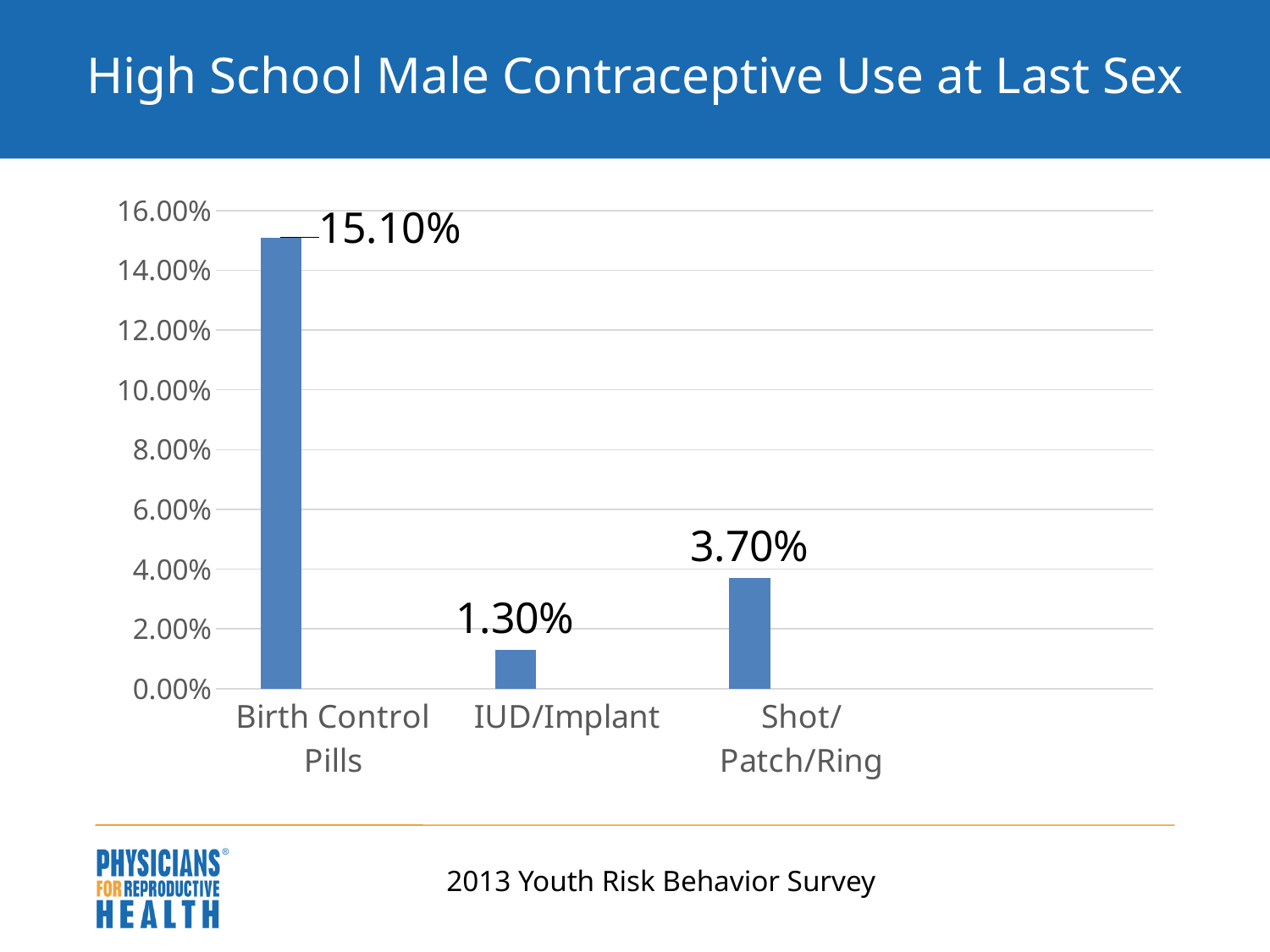
Which category has the highest value? Birth Control Pills What is the title of the slide containing the chart? High School Male Contraceptive Use at Last Sex What kind of chart is shown on the slide? bar chart What is the value for Birth Control Pills? 15.10% What is the value for IUD/Implant? 1.30% What is the difference between the values for Birth Control Pills and Shot/Patch/Ring? 11.40% Which category has the lowest value? IUD/Implant Which is larger, the value for IUD/Implant or the value for Shot/Patch/Ring? Shot/Patch/Ring What is the value for Shot/Patch/Ring? 3.70% Is the value for Birth Control Pills greater or less than 14.00%? greater What is the difference between the values for Shot/Patch/Ring and IUD/Implant? 2.40% How many categories are shown on the chart? 3